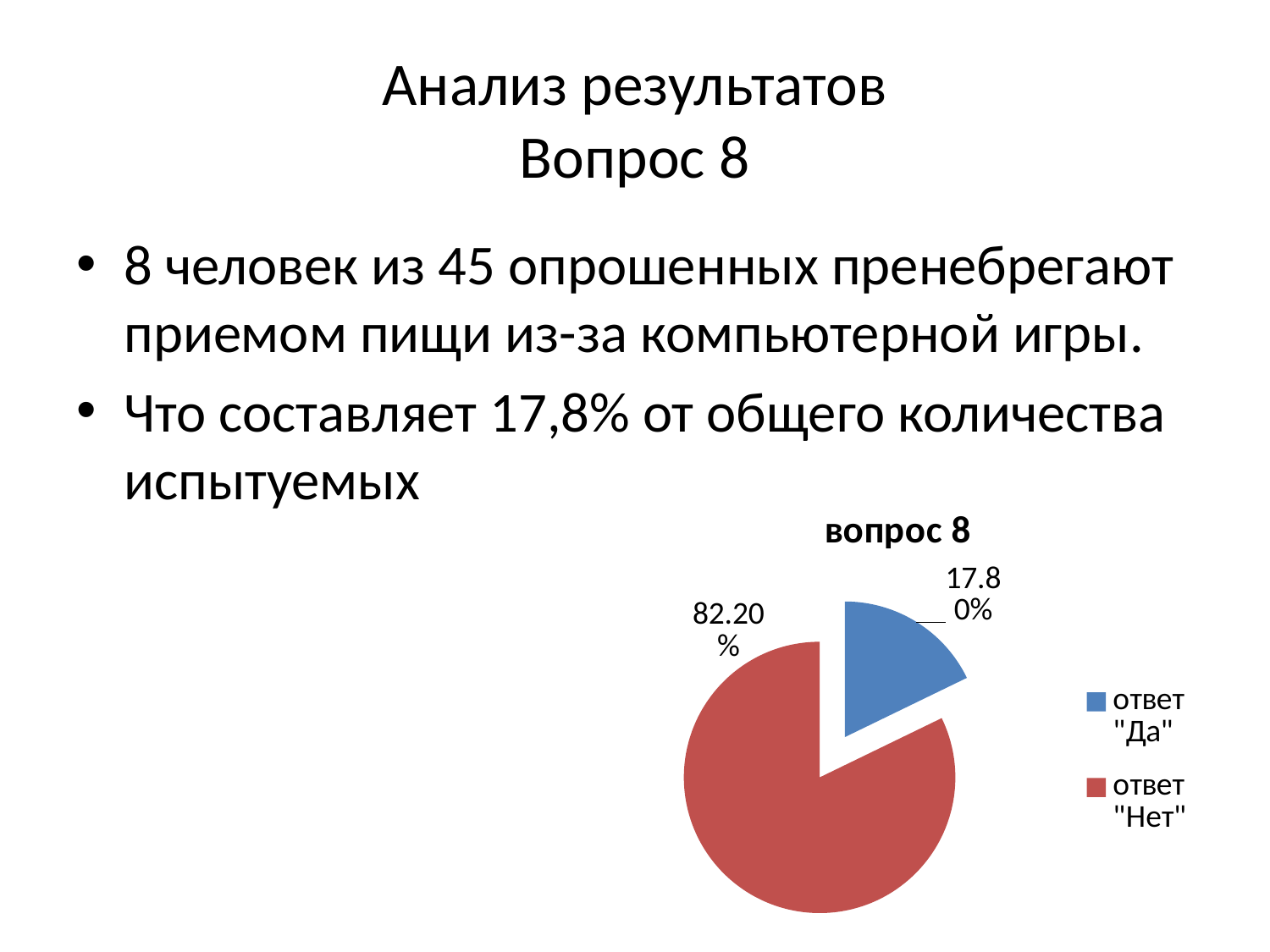
How many slices does the pie chart have? 2 What percentage is shown for the slice 'ответ "Да"'? 17.80% Which slice of the pie is the largest? ответ "Нет" Which is larger, the slice for 'ответ "Да"' or the slice for 'ответ "Нет"'? ответ "Нет" How many entries does the legend list? 2 What percentage is shown for the slice 'ответ "Нет"'? 82.20% What is the title of the chart? вопрос 8 What type of chart is shown on the slide? pie chart Which slice of the pie is the smallest? ответ "Да" What colour is the slice for 'ответ "Нет"'? red What is the difference in percentage points between the 'ответ "Нет"' slice and the 'ответ "Да"' slice? 64.40%